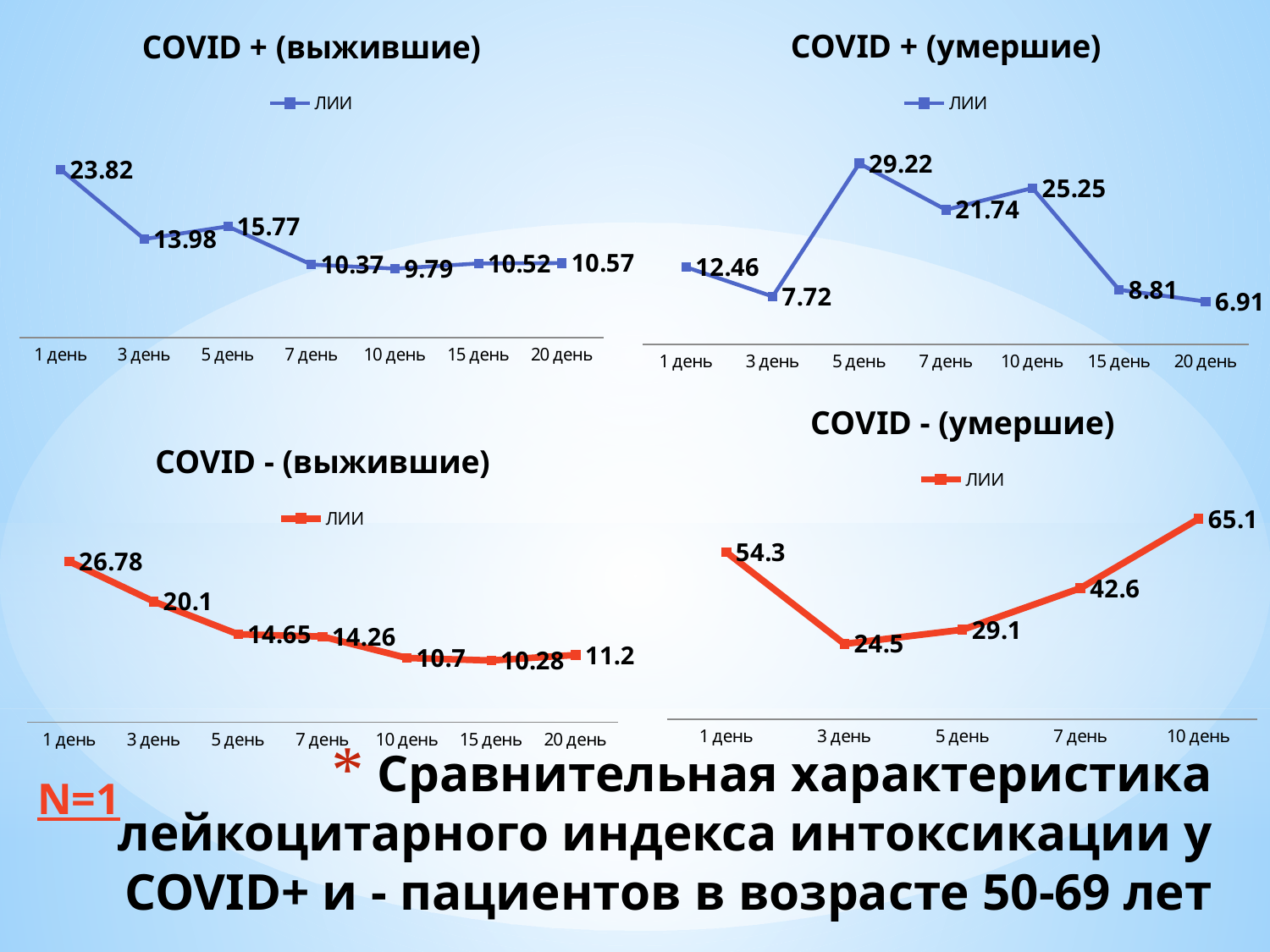
In the "COVID - (умерш��е)" chart, what is the ЛИИ value on 10 день? 65.1 In the "COVID - (умершие)" chart, which is larger: the ЛИИ value on 1 день or on 7 день? 1 день In the "COVID - (выжившие)" chart, what is the difference between the ЛИИ values on 1 день and 3 день? 6.68 What type of chart is the "COVID - (выжившие)" chart? Line chart What colour is the line in the "COVID - (умершие)" chart? Red In the "COVID + (умершие)" chart, on which day is the ЛИИ value highest? 5 день In the "COVID - (выжившие)" chart, does the ЛИИ value generally rise or fall from 1 день to 10 день? Fall How many data points are plotted in the "COVID - (умершие)" chart? 5 How many data points are plotted in the "COVID + (выжившие)" chart? 7 In the "COVID + (выжившие)" chart, what is the ЛИИ value on 1 день? 23.82 How many series does the legend of the "COVID + (умершие)" chart list? 1 In the "COVID + (умершие)" chart, on which day is the ЛИИ value lowest? 20 день